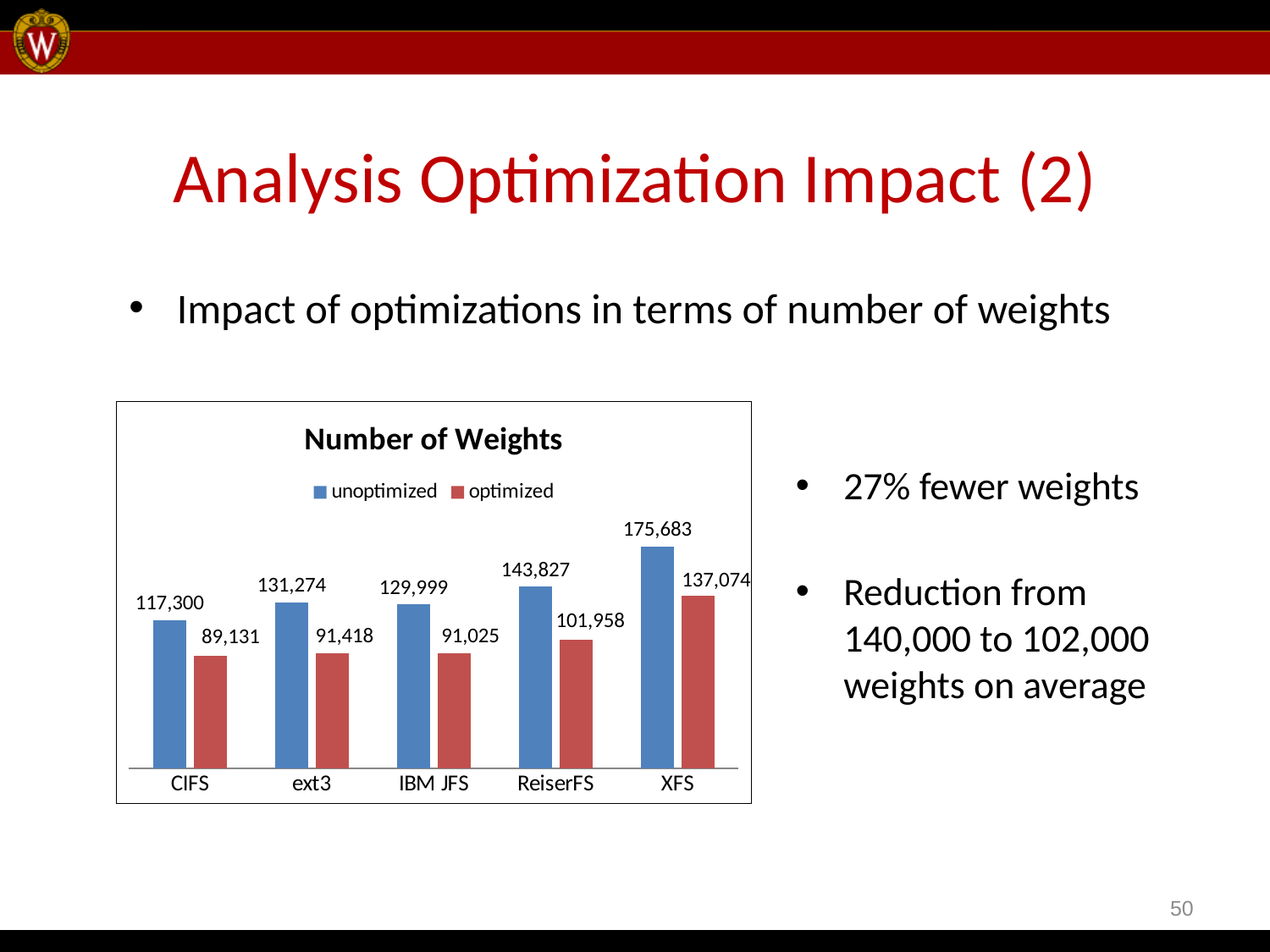
Which file system has the highest unoptimized number of weights? XFS Which colour represents the optimized series in the chart? red What is the title of the chart? Number of Weights What is the optimized number of weights for CIFS? 89,131 What is the unoptimized number of weights for XFS? 175,683 What kind of chart is shown on the slide? bar chart Which file system has the lowest optimized number of weights? CIFS What is the optimized number of weights for ReiserFS? 101,958 How many series does the chart legend list? 2 What is the difference between the unoptimized and optimized number of weights for IBM JFS? 38,974 How many file systems are shown on the x axis of the chart? 5 Which is larger, the optimized number of weights for ext3 or for IBM JFS? ext3